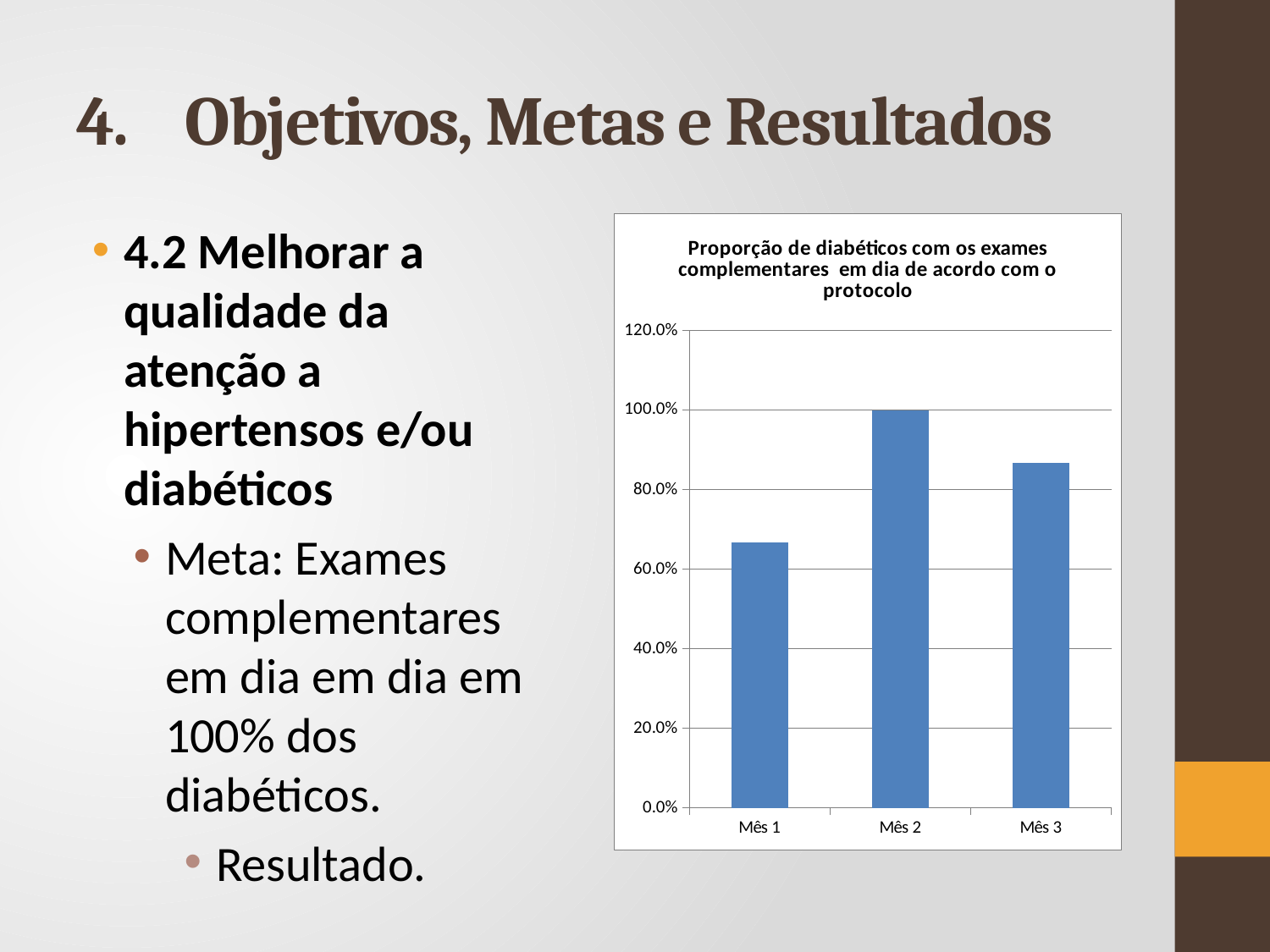
Which is larger, the value for Mês 3 or the value for Mês 1? Mês 3 What kind of chart is shown on the slide? bar chart Is the value for Mês 1 greater or less than 80.0%? less Is the value for Mês 1 greater or less than 60.0%? greater Is the value for Mês 3 greater or less than 80.0%? greater Which month has the lowest proportion of diabetics with complementary exams up to date? Mês 1 What is the highest value shown on the y axis of the chart? 120.0% How many categories are plotted on the x axis of the chart? 3 What is the title of the chart? Proporção de diabéticos com os exames complementares em dia de acordo com o protocolo What is the value for Mês 2 in the chart? 100.0% Which month has the highest proportion of diabetics with complementary exams up to date? Mês 2